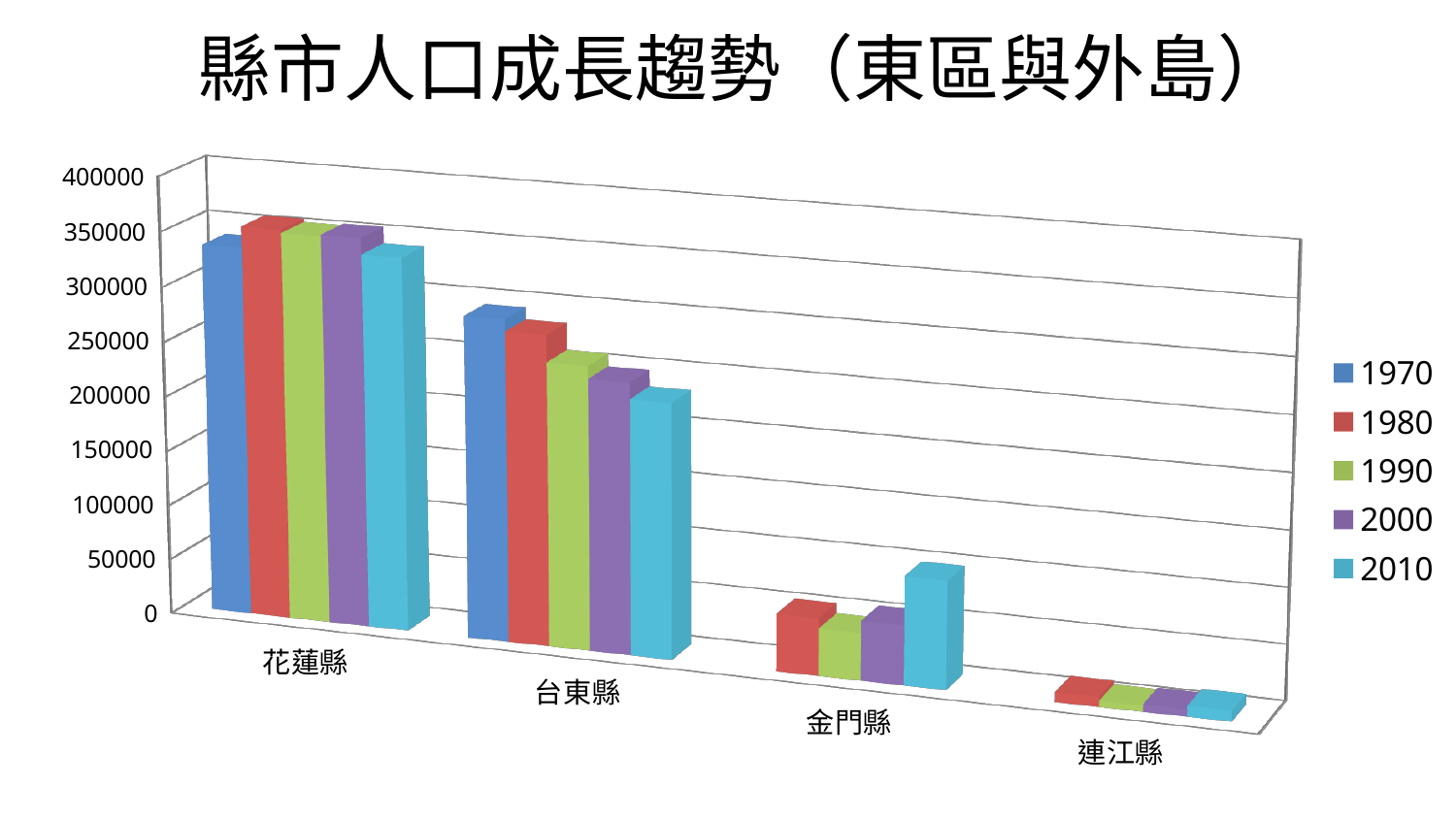
For 台東縣, do the values rise or fall from 1970 to 2010? fall Is the 2010 value for 台東縣 greater or less than 250000? less How many series does the legend list? 5 What kind of chart is shown on the slide? bar chart Which county has the highest population bars overall? 花蓮縣 Which county has the lowest population bars overall? 連江縣 How many counties (categories) are shown on the x axis? 4 Which is larger, the 1970 value for 花蓮縣 or the 1970 value for 台東縣? 花蓮縣 Is the 1980 value for 花蓮縣 greater or less than 300000? greater For 金門縣, which year has the tallest bar? 2010